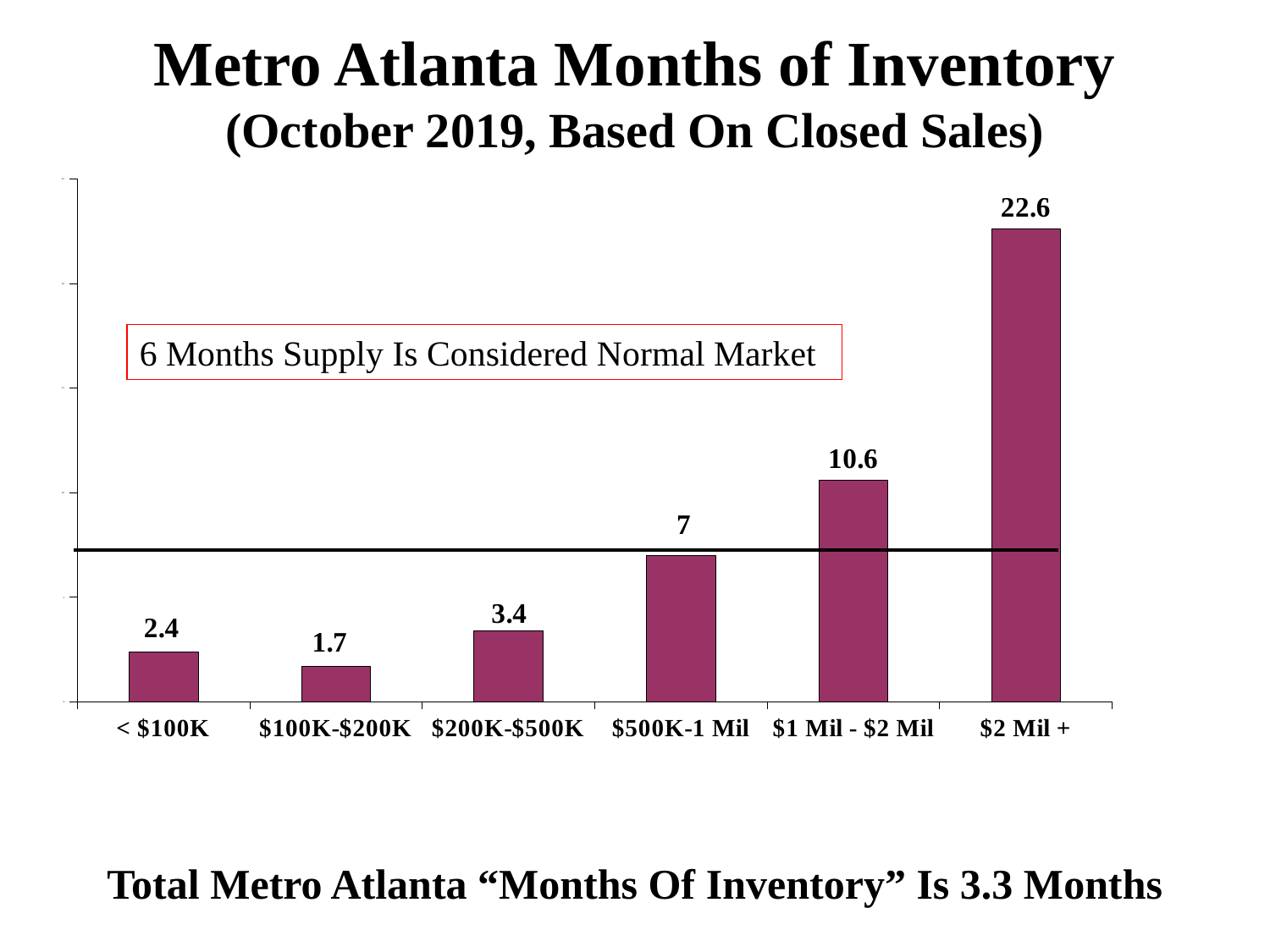
Which price range has the lowest months of inventory? $100K-$200K What is the difference in months of inventory between the < $100K and $100K-$200K price ranges? 0.7 What is the months of inventory value for the $100K-$200K price range? 1.7 What is the difference in months of inventory between the $2 Mil + and $1 Mil - $2 Mil price ranges? 12 Which price range has the highest months of inventory? $2 Mil + According to the text box on the chart, how many months of supply is considered a normal market? 6 months What kind of chart is shown on the slide? Bar chart What is the months of inventory value for the $500K-1 Mil price range? 7 Which has a larger months of inventory value, $200K-$500K or $500K-1 Mil? $500K-1 Mil How many price range categories are shown in the chart? 6 What is the months of inventory value for the $2 Mil + price range? 22.6 Do the months of inventory values generally rise or fall as the price range increases from $100K-$200K to $2 Mil +? Rise